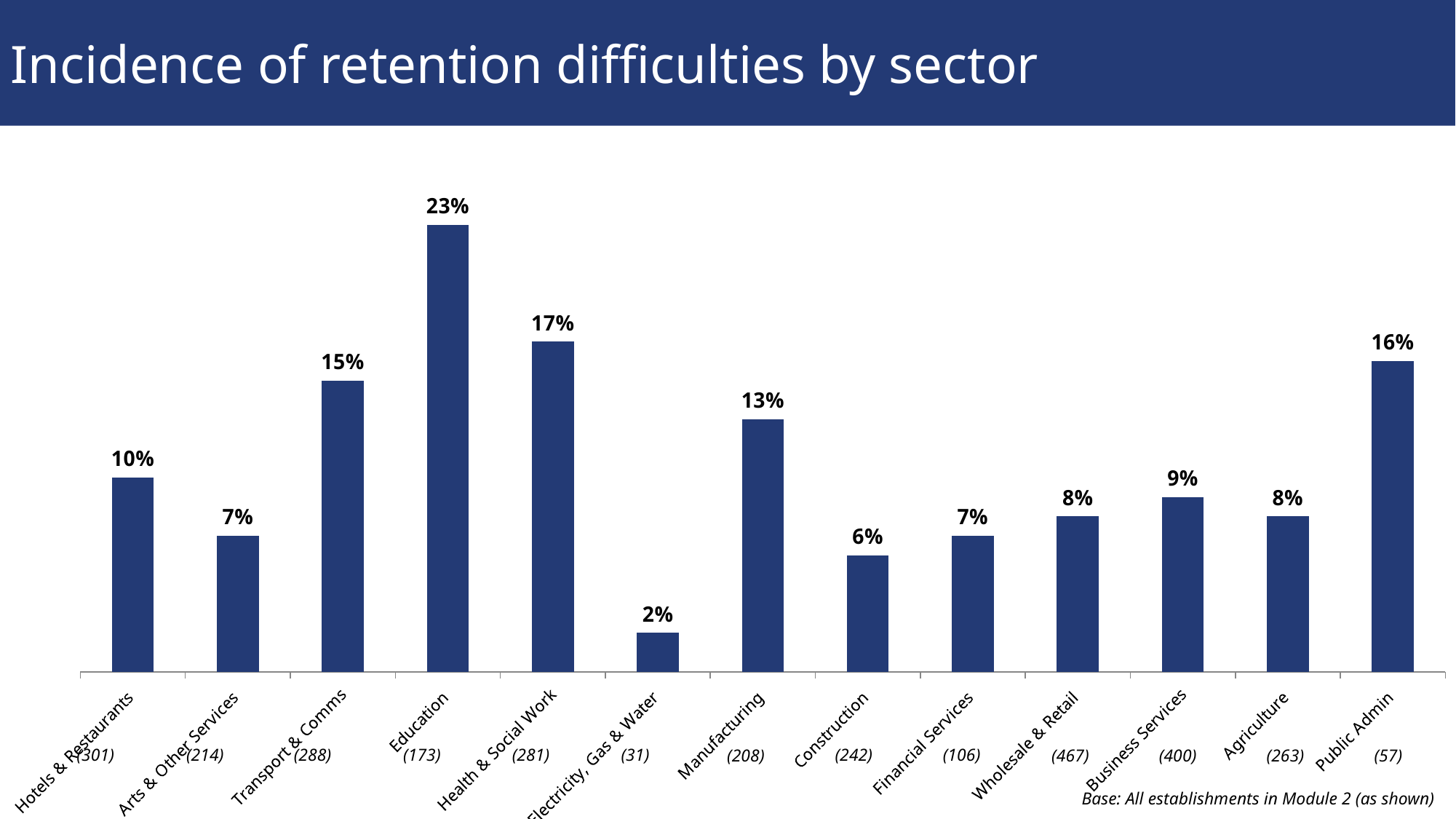
Which sector has the highest incidence of retention difficulties? Education What is the base size shown for Wholesale & Retail? 467 What is the value for Electricity, Gas & Water? 2% What is the title of the chart? Incidence of retention difficulties by sector What kind of chart is shown on the slide? Bar chart What is the difference between the values for Education and Manufacturing? 10% What is the value for Health & Social Work? 17% What is the value for Public Admin? 16% Which sector has the lowest incidence of retention difficulties? Electricity, Gas & Water Which is larger, the value for Transport & Comms or the value for Manufacturing? Transport & Comms How many sectors are shown in the chart? 13 What is the value for Education? 23%